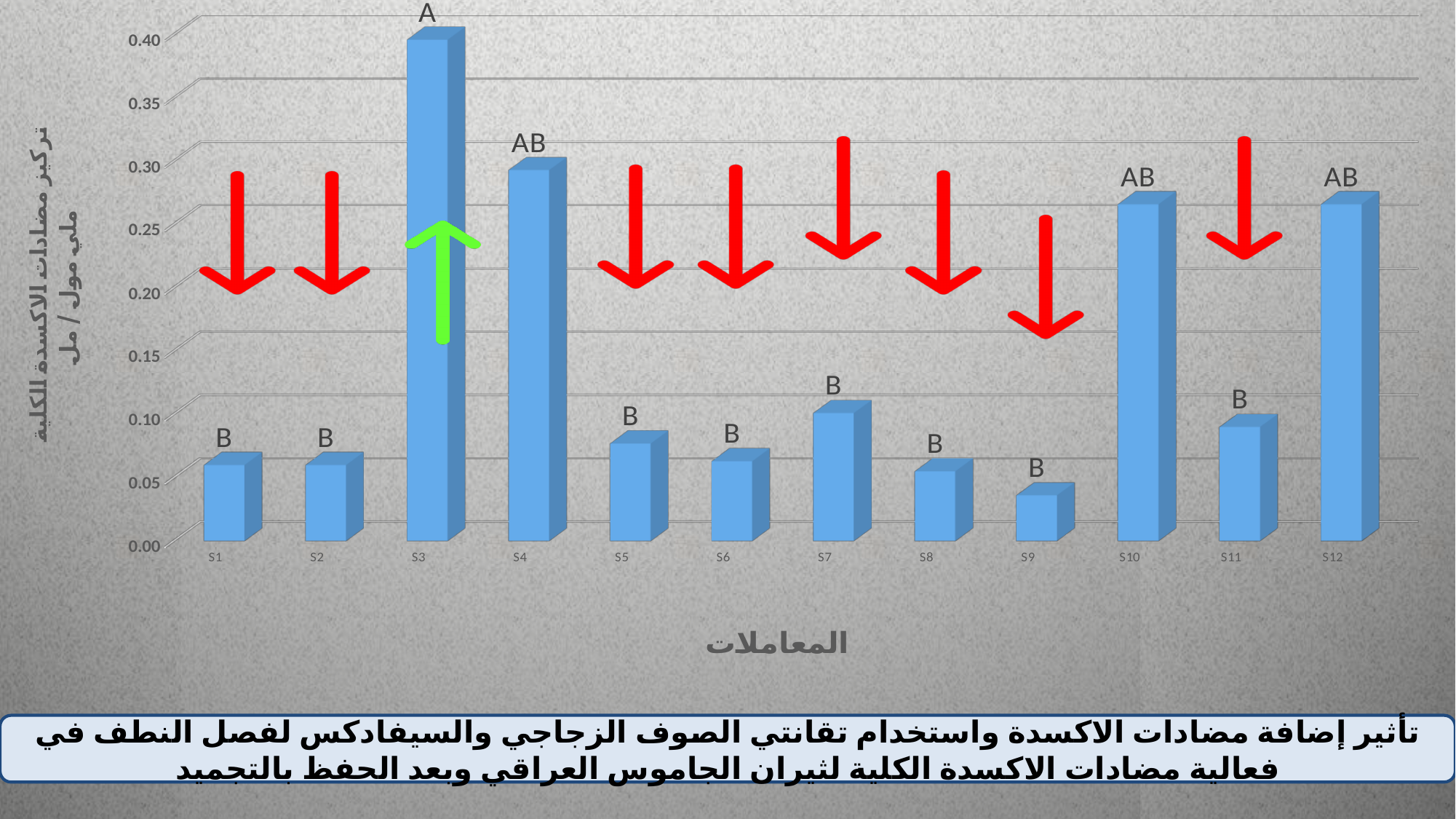
What letter label is printed above the bar for S3? A Is the value for S4 greater or less than 0.25? greater What kind of chart is shown on the slide? bar chart Which treatment has the highest value? S3 Which is larger, the value for S3 or the value for S4? S3 Which treatment has the lowest value? S9 Is the value for S3 greater or less than 0.35? greater Is the value for S1 greater or less than 0.10? less Which is larger, the value for S10 or the value for S11? S10 How many categories (treatments) are plotted on the x axis? 12